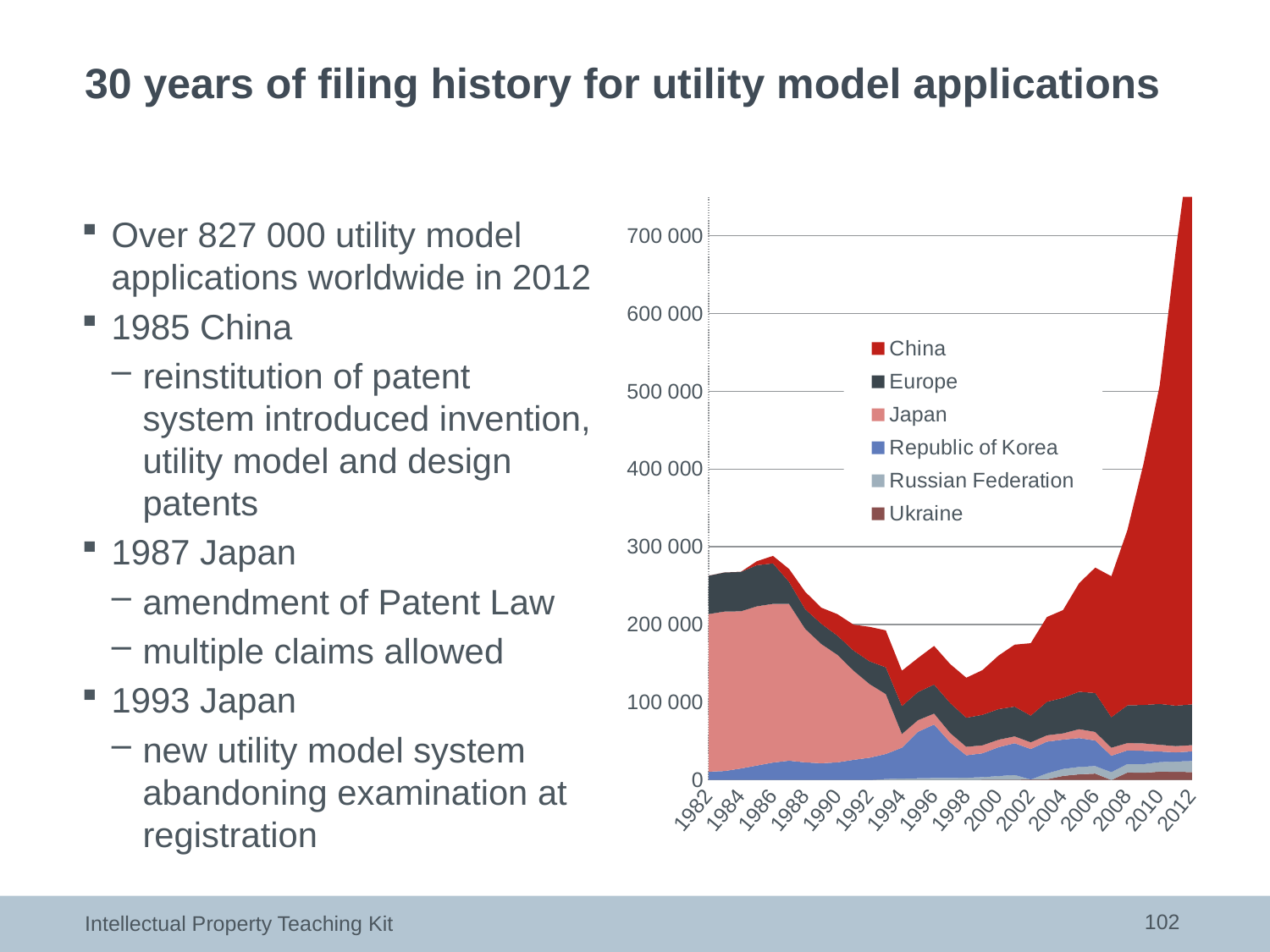
How many year labels are shown along the x axis of the chart? 16 Which series is listed first in the chart legend? China Is the total value for 2012 greater or less than 700 000? greater Does the total value rise or fall between 2006 and 2012? rise Which series accounts for the largest share of the total in 2012? China How many series does the chart legend list? 6 What colour represents China in the chart? red Is the total value for 1982 greater or less than 200 000? greater Which series accounts for the largest share of the total in 1982? Japan Is the total value for 1998 greater or less than 200 000? less What kind of chart is shown on the slide? stacked area chart